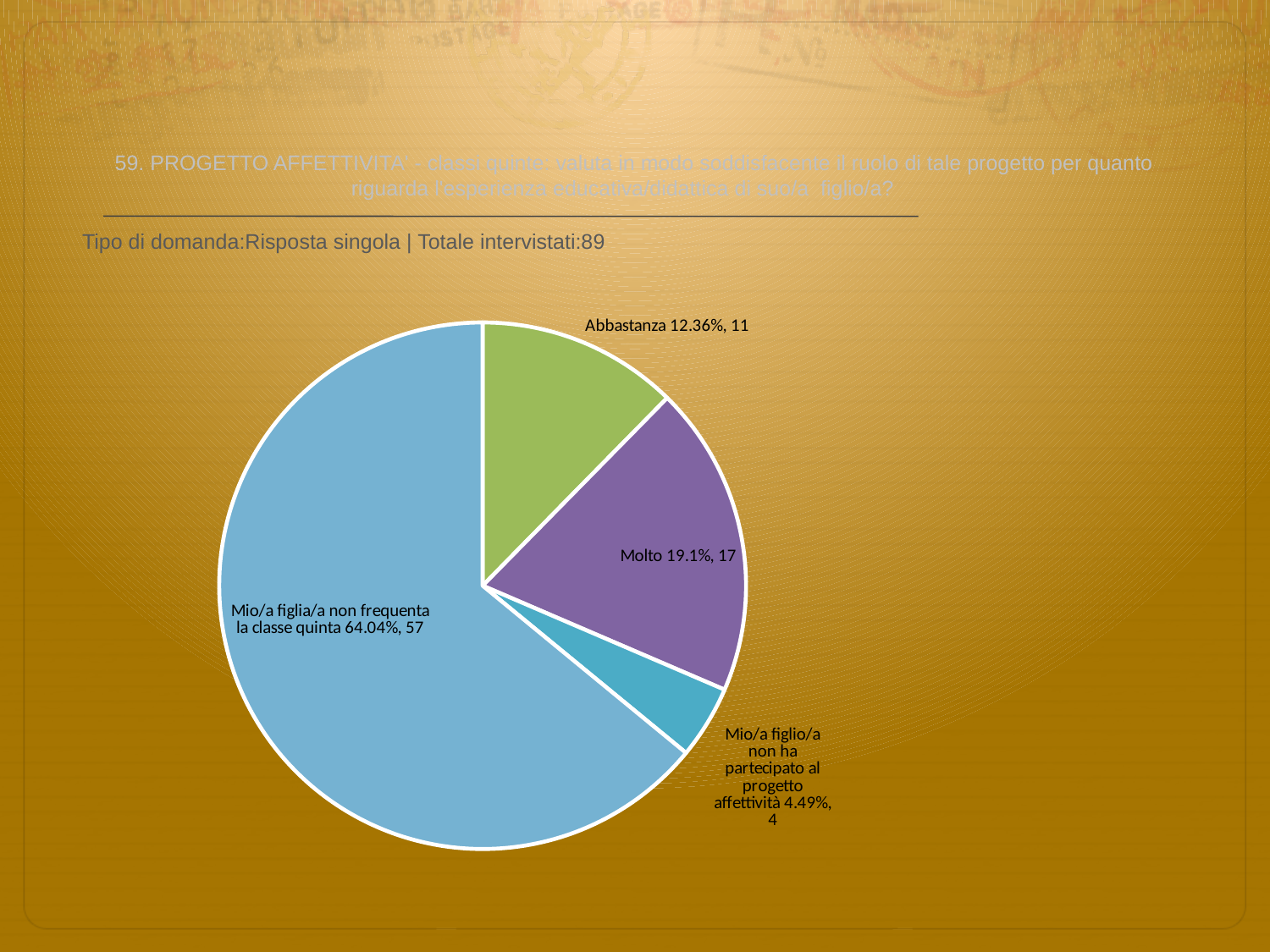
What percentage is shown for the 'Molto' slice? 19.1% How many slices does the pie chart have? 4 According to the subtitle, what is the total number of respondents (Totale intervistati)? 89 How many respondents answered 'Abbastanza'? 11 What is the difference in respondent count between 'Molto' and 'Abbastanza'? 6 Which slice of the pie chart is the smallest? Mio/a figlio/a non ha partecipato al progetto affettività What kind of chart is shown on the slide? pie chart Which slice of the pie chart is the largest? Mio/a figlia/a non frequenta la classe quinta What percentage is shown for 'Mio/a figlia/a non frequenta la classe quinta'? 64.04% What share of the pie does the 'Abbastanza' slice represent? 12.36% How many respondents chose 'Mio/a figlio/a non ha partecipato al progetto affettività'? 4 Which has more respondents, 'Molto' or 'Abbastanza'? Molto